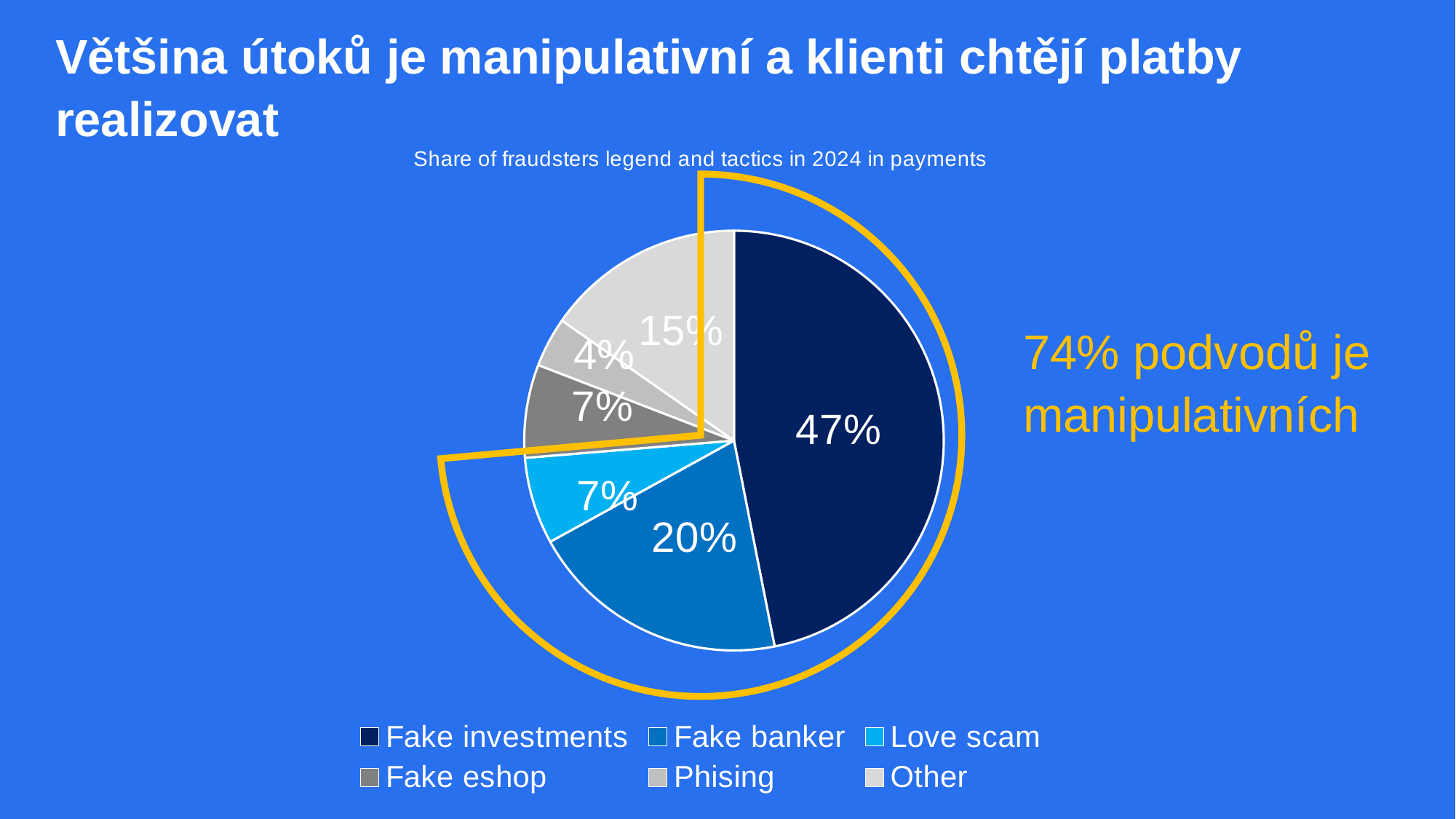
What share of the pie does Fake banker hold? 20% What is the difference in percentage points between Fake investments and Fake banker? 27 Which category has the smallest slice of the pie? Phising What share of the pie does Phising hold? 4% How many categories does the pie chart show? 6 What share of the pie does Other hold? 15% What share of the pie does Love scam hold? 7% What is the title of the chart? Share of fraudsters legend and tactics in 2024 in payments Which category has the largest slice of the pie? Fake investments Which is larger, the share for Other or the share for Fake eshop? Other What share of the pie does Fake investments hold? 47% What kind of chart is shown on the slide? Pie chart